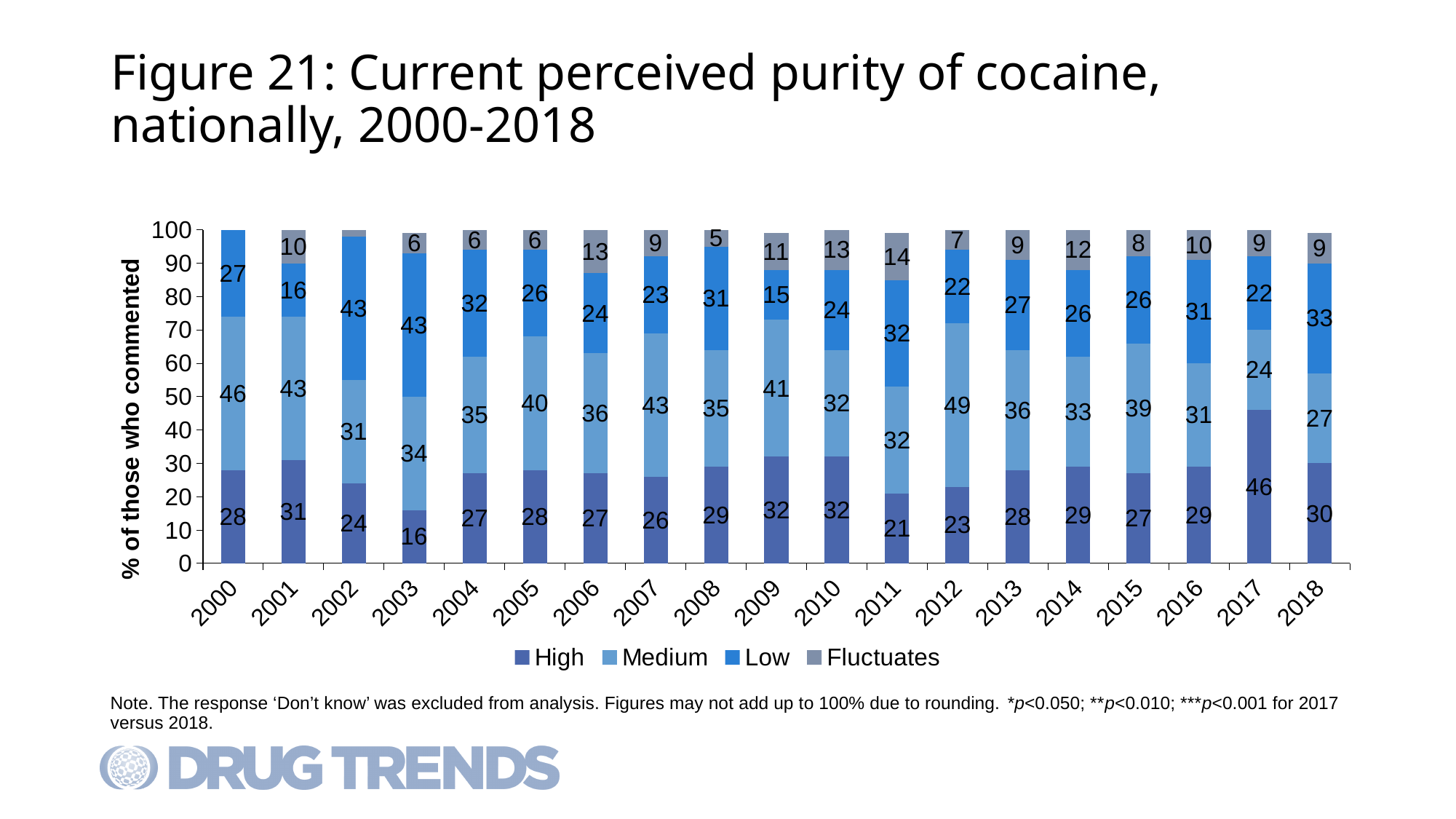
What is the value for Fluctuates in 2011? 14 How many series does the legend list? 4 What is the value for High in 2017? 46 What is the value for Medium in 2012? 49 What is the total of the stacked bar for 2018 (High + Medium + Low + Fluctuates)? 99 What is the difference between the High value in 2017 and the High value in 2018? 16 What kind of chart is shown on the slide? Stacked bar chart How many years are shown on the x axis? 19 In which year is the High segment the largest? 2017 In which year is the High segment the smallest? 2003 What is the value for Low in 2003? 43 Which is larger, the Low value in 2018 or the Low value in 2017? 2018